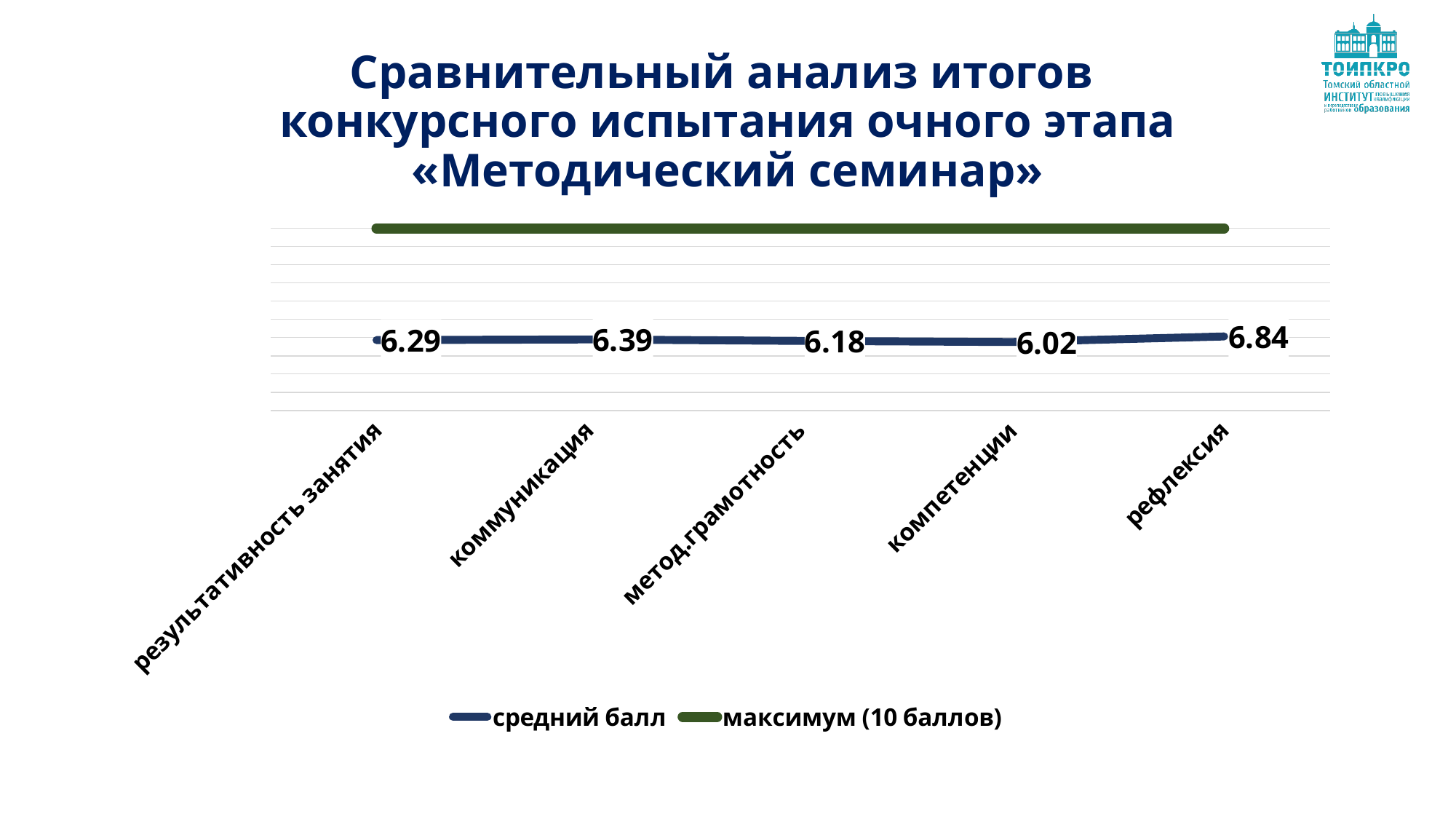
What is the average score (средний балл) for коммуникация? 6.39 Which category has the lowest average score (средний балл)? компетенции What is the difference between the average scores for рефлексия and компетенции? 0.82 Which category has the highest average score (средний балл)? рефлексия What is the average score (средний балл) for компетенции? 6.02 What is the average score (средний балл) for рефлексия? 6.84 What is the average score (средний балл) for метод.грамотность? 6.18 How many categories are shown on the x axis? 5 How many series does the legend list? 2 Which has a higher average score, результативность занятия or коммуникация? коммуникация What is the name of the series drawn in green in the legend? максимум (10 баллов) What kind of chart is shown on the slide? line chart